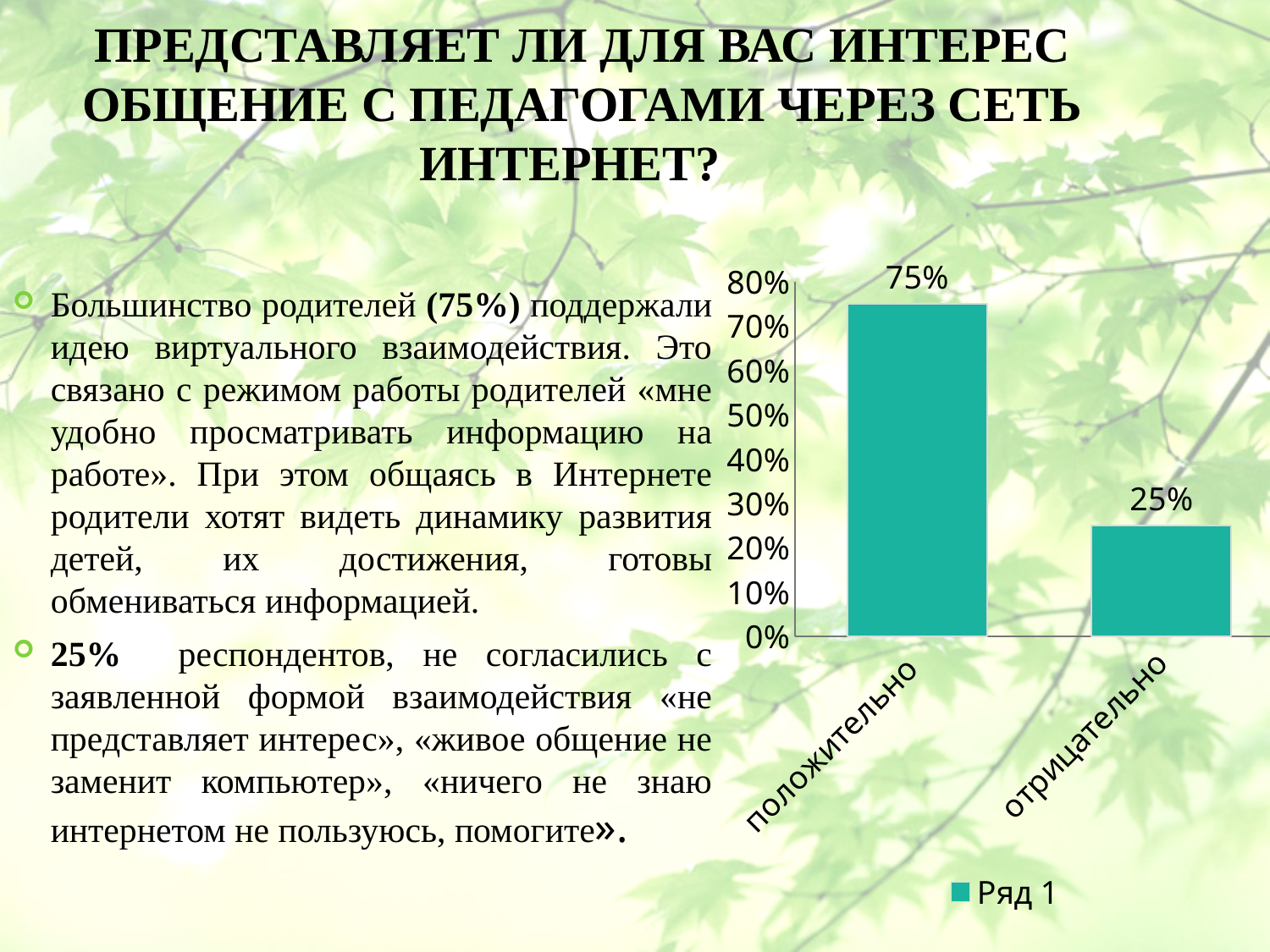
How many categories are shown on the x axis? 2 Which category has the lowest value? отрицательно What is the value for отрицательно? 25% Which is larger, the value for положительно or the value for отрицательно? положительно What is the name of the series in the legend? Ряд 1 What kind of chart is shown on the slide? bar chart Is the value for отрицательно greater or less than 30%? less What is the difference between the values for положительно and отрицательно? 50% Is the value for положительно greater or less than 70%? greater Which category has the highest value? положительно What is the value for положительно? 75% How many series does the legend list? 1